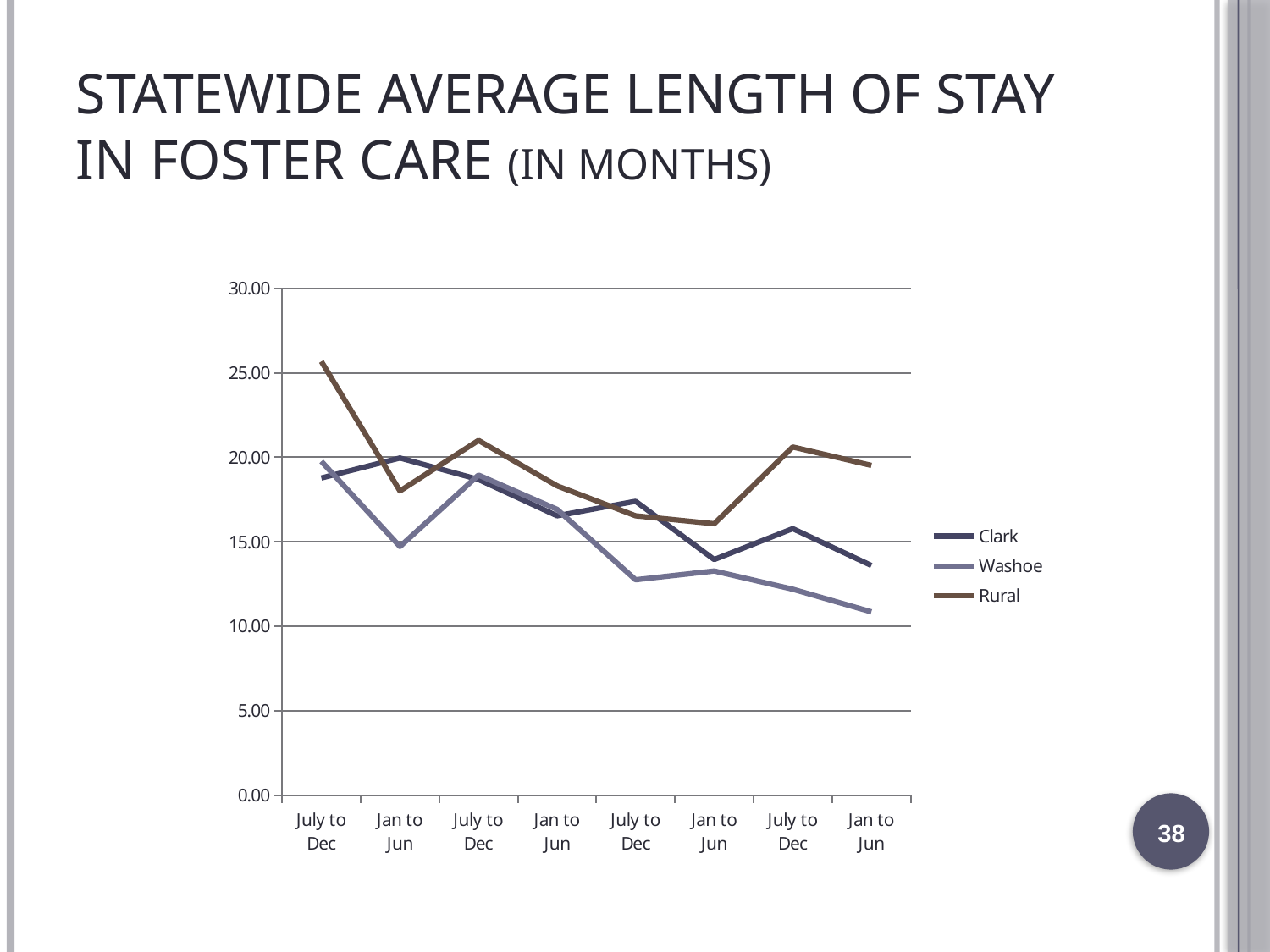
Which series has the lowest value in the last period (Jan to Jun, rightmost)? Washoe Is the Washoe value in the fifth period (third July to Dec) greater or less than 15? less Is the Rural value in the first period (July to Dec, leftmost) greater or less than 20? greater How many series does the legend list? 3 What kind of chart is shown on the slide? line chart Does the Washoe line generally rise or fall from the first period to the last? fall In the fifth period (third July to Dec), which is larger, the Clark value or the Washoe value? Clark Which series has the highest value in the last period (Jan to Jun, rightmost)? Rural Which series is drawn in brown? Rural Is the Washoe value in the last period (rightmost) greater or less than 15? less How many time periods are plotted along the x axis? 8